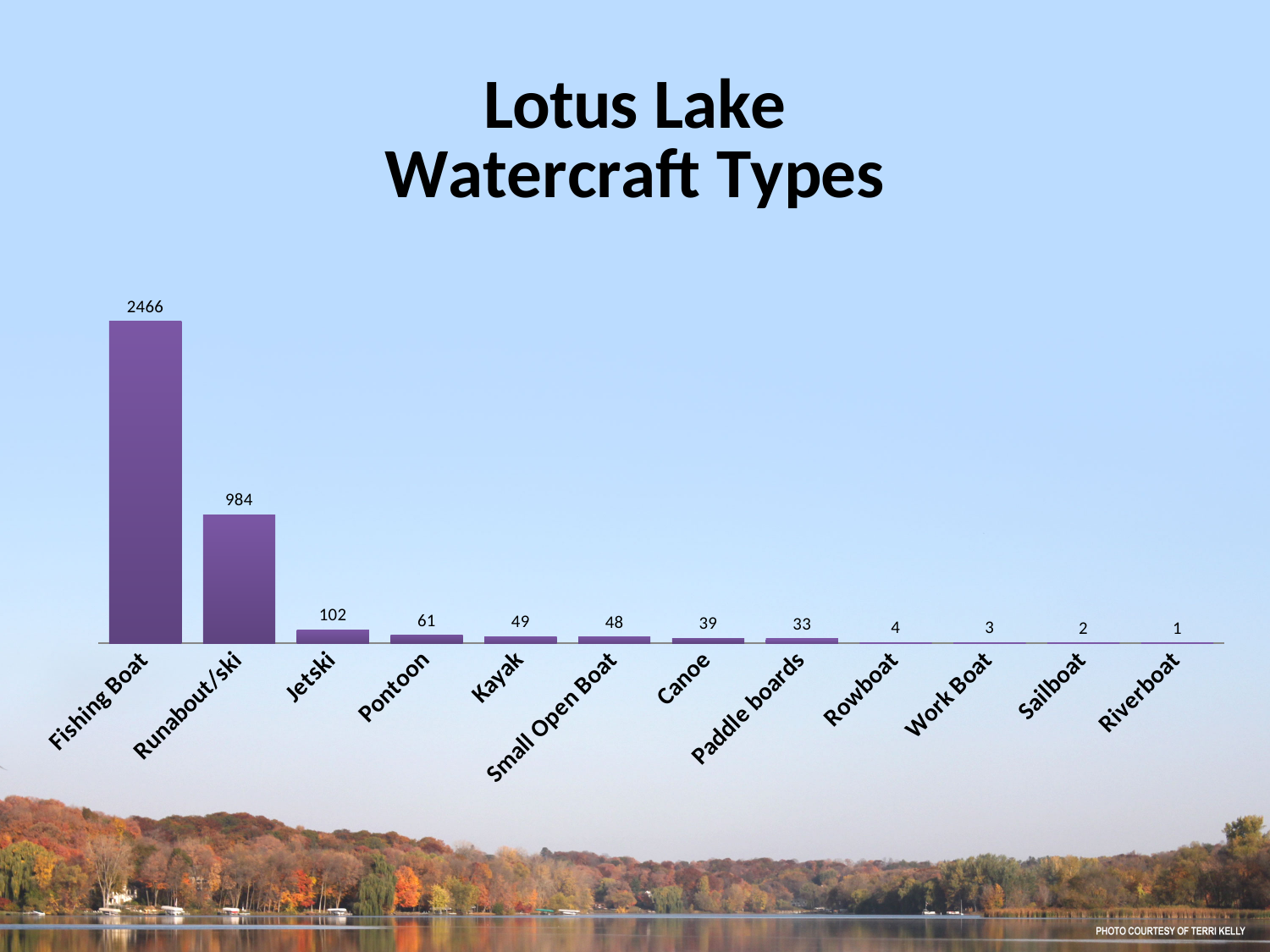
Which watercraft type has the lowest value? Riverboat What is the value for Fishing Boat? 2466 Which is larger, the value for Canoe or the value for Small Open Boat? Small Open Boat Which watercraft type has the highest value? Fishing Boat How many watercraft types are shown on the chart? 12 What is the difference between the values for Jetski and Kayak? 53 What is the value for Runabout/ski? 984 What is the value for Pontoon? 61 What is the difference between the values for Fishing Boat and Runabout/ski? 1482 What is the title of the chart? Lotus Lake Watercraft Types What kind of chart is shown on the slide? Bar chart What is the value for Paddle boards? 33